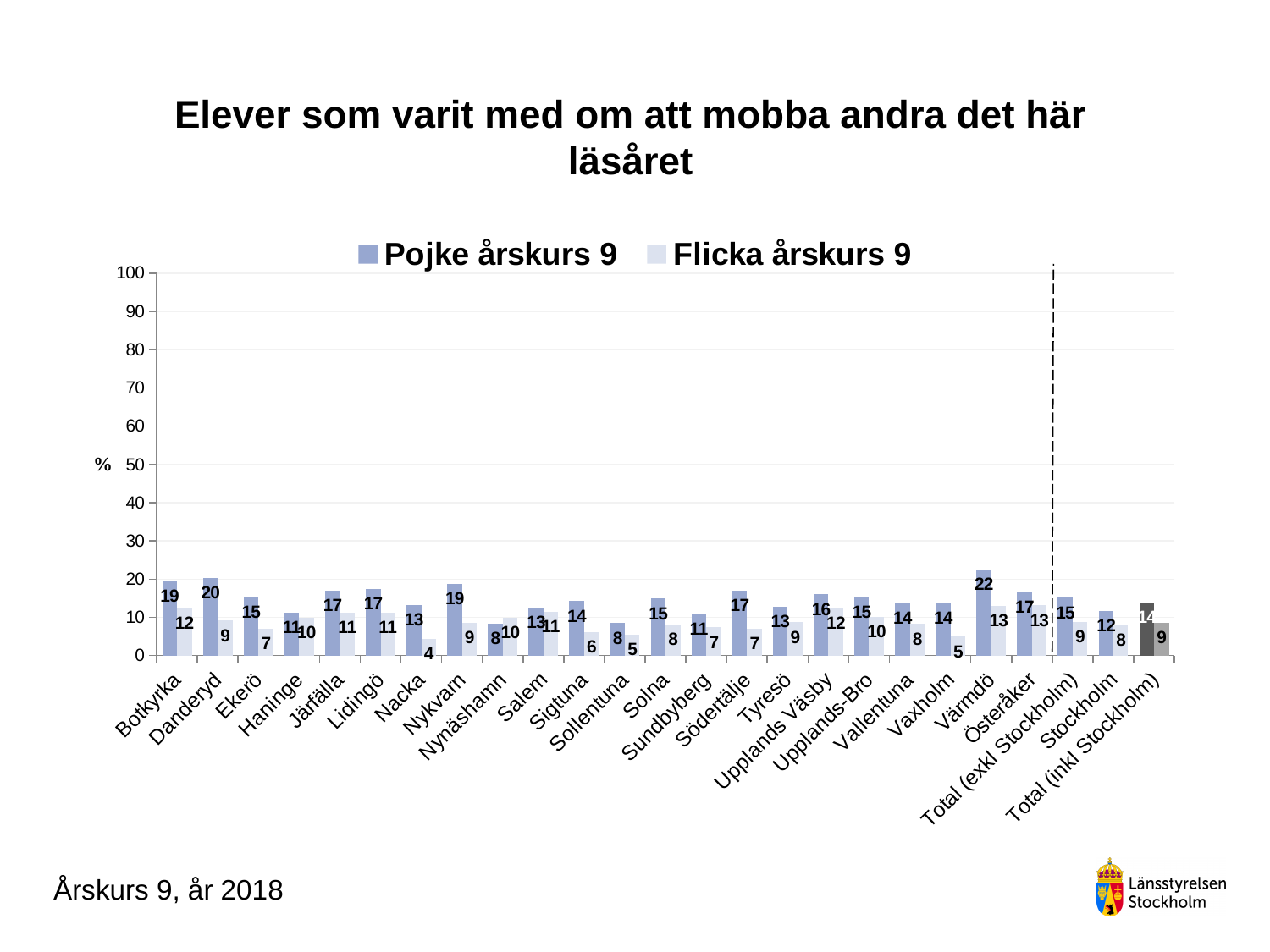
What is the value for Flicka årskurs 9 in Total (inkl Stockholm)? 9 Is the value for Pojke årskurs 9 in Värmdö greater or less than 20? greater What is the difference between the Pojke årskurs 9 and Flicka årskurs 9 values in Danderyd? 11 How many series does the legend list? 2 How many categories are shown on the x axis? 25 What is the value for Pojke årskurs 9 in Värmdö? 22 What is the value for Flicka årskurs 9 in Botkyrka? 12 Which municipality has the lowest value for Flicka årskurs 9? Nacka Which municipality has the highest value for Pojke årskurs 9? Värmdö Which is larger in Nynäshamn, the Pojke årskurs 9 value or the Flicka årskurs 9 value? Flicka årskurs 9 What kind of chart is shown on the slide? Bar chart What is the value for Pojke årskurs 9 in Stockholm? 12